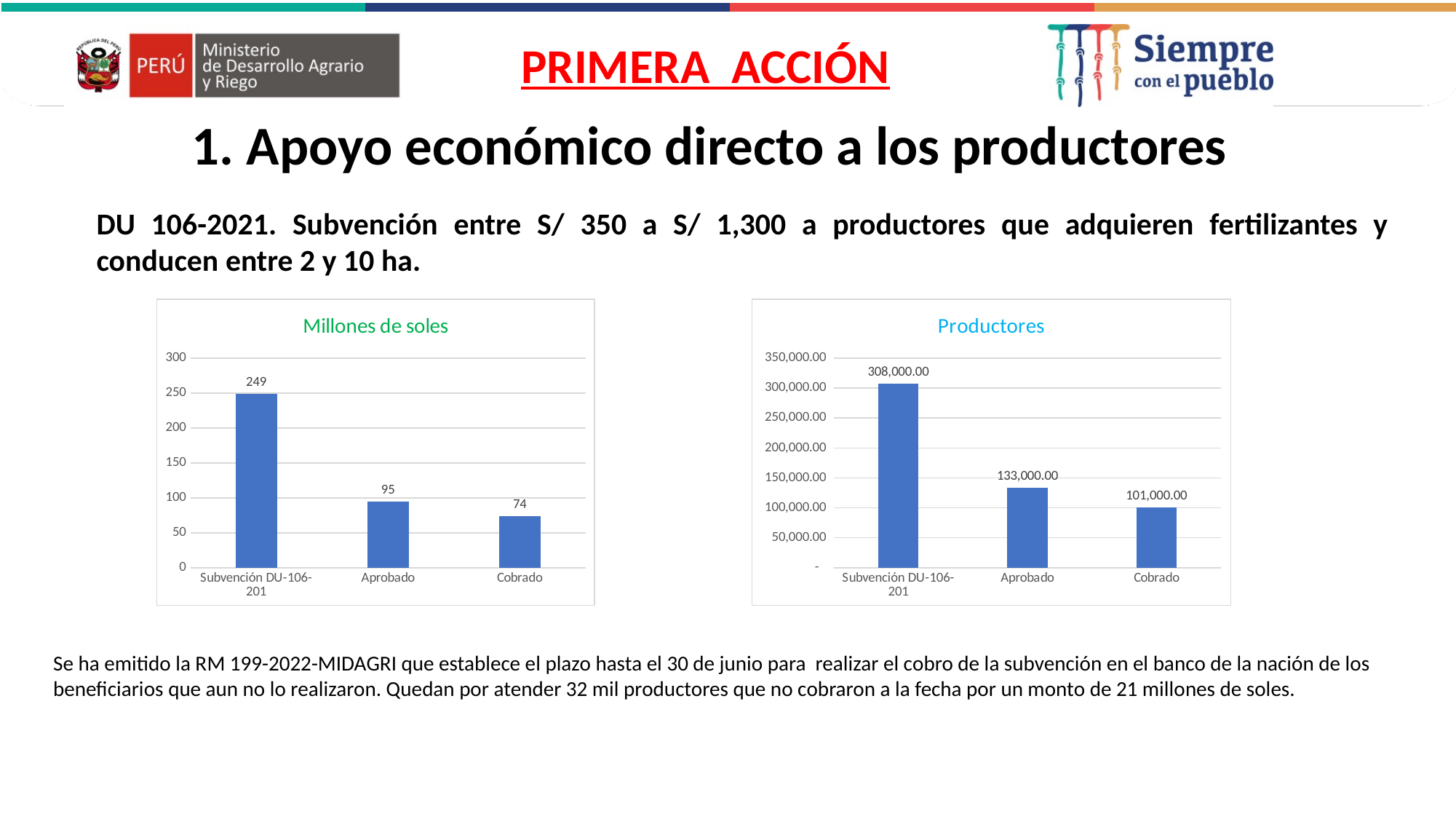
In the 'Millones de soles' chart, what is the value for Aprobado? 95 In the 'Millones de soles' chart, which category has the highest value? Subvención DU-106-201 In the 'Productores' chart, which category has the lowest value? Cobrado In the 'Millones de soles' chart, what is the value for Cobrado? 74 What kind of chart is the 'Millones de soles' chart? Bar chart In the 'Productores' chart, which is larger, Aprobado or Cobrado? Aprobado In the 'Productores' chart, what is the value for Cobrado? 101,000.00 In the 'Millones de soles' chart, is the value for Cobrado greater or less than 100? less In the 'Productores' chart, what is the value for Subvención DU-106-201? 308,000.00 How many categories does the 'Productores' chart show? 3 In the 'Millones de soles' chart, what is the difference between Subvención DU-106-201 and Aprobado? 154 In the 'Productores' chart, what is the difference between Aprobado and Cobrado? 32,000.00